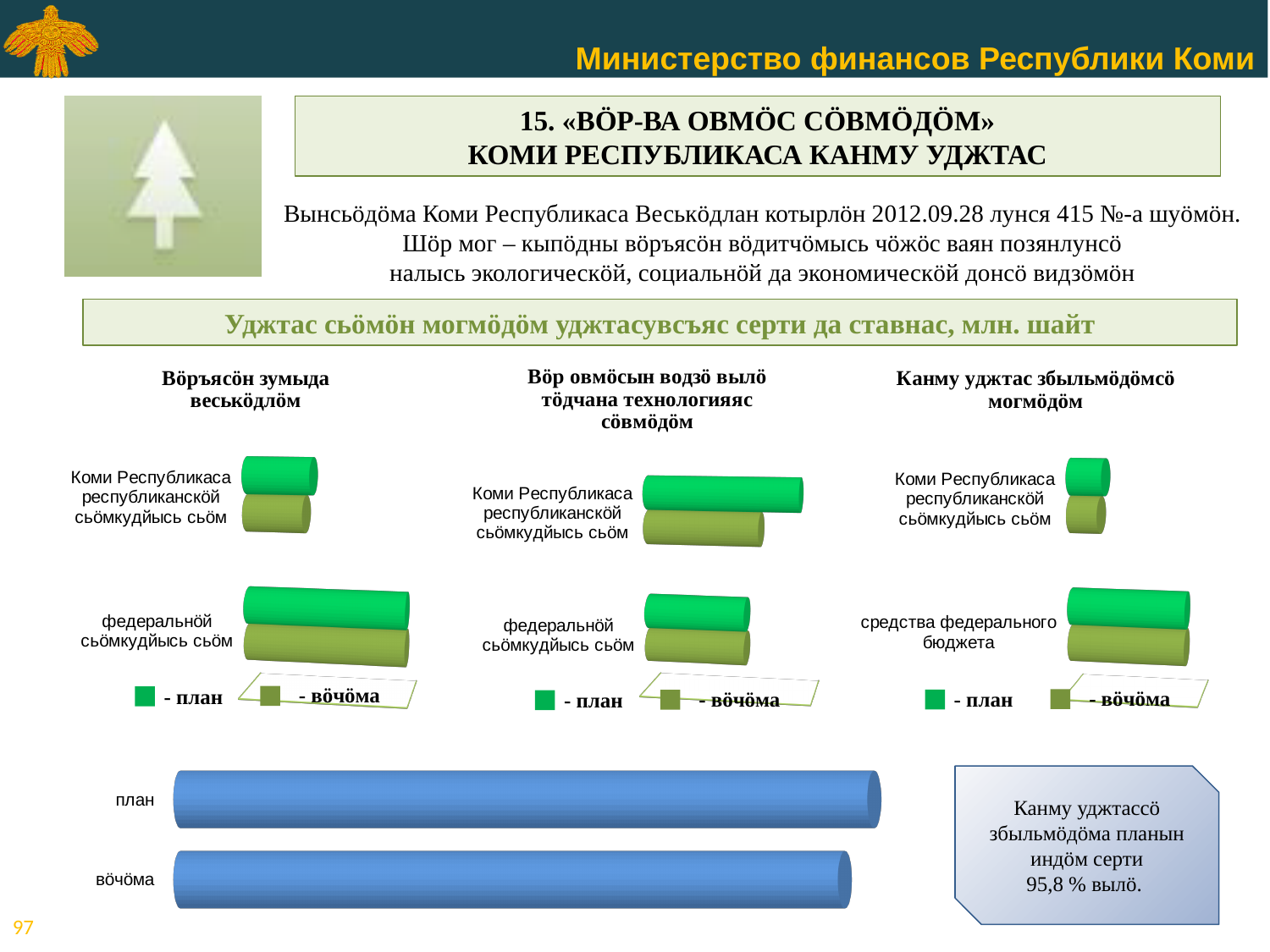
In the chart titled "Вöр овмöсын водзö вылö тöдчана технологияяс сöвмöдöм", for Коми Республикаса республиканскöй сьöмкудйысь сьöм, which bar is longer: план or вöчöма? план How many categories does the chart titled "Вöръясöн зумыда веськöдлöм" show? 2 In the chart titled "Вöр овмöсын водзö вылö тöдчана технологияяс сöвмöдöм", which category has the longer план bar: Коми Республикаса республиканскöй сьöмкудйысь сьöм or федеральнöй сьöмкудйысь сьöм? Коми Республикаса республиканскöй сьöмкудйысь сьöм How many bars does the blue chart at the bottom of the slide show? 2 In the chart titled "Канму уджтас збыльмöдöмсö могмöдöм", which category has the longer bars: Коми Республикаса республиканскöй сьöмкудйысь сьöм or средства федерального бюджета? средства федерального бюджета What kind of chart is the chart titled "Вöръясöн зумыда веськöдлöм"? bar chart What kind of chart is the blue chart at the bottom of the slide? bar chart How many categories does the chart titled "Канму уджтас збыльмöдöмсö могмöдöм" show? 2 How many series does the legend of the chart titled "Вöръясöн зумыда веськöдлöм" list? 2 What are the two legend entries of the chart titled "Канму уджтас збыльмöдöмсö могмöдöм"? план, вöчöма